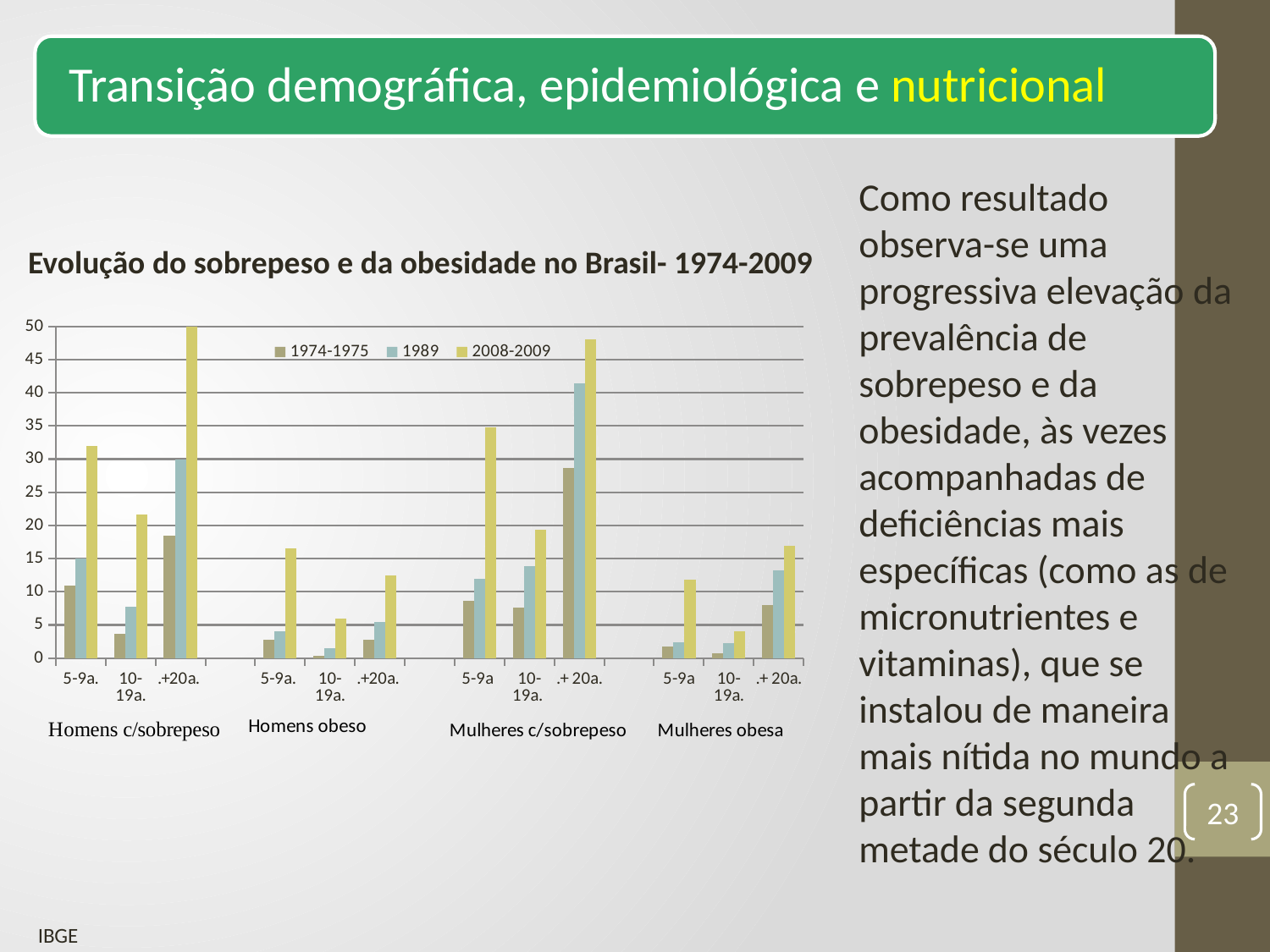
What is the title of the chart? Evolução do sobrepeso e da obesidade no Brasil- 1974-2009 Which group and age band has the tallest bar in the chart? Homens c/sobrepeso, .+20a. (2008-2009) What are the three series named in the legend? 1974-1975, 1989, 2008-2009 Is the 1989 value for Mulheres c/sobrepeso aged .+ 20a. greater or less than 40? greater Within each age band, do the values rise or fall from 1974-1975 to 2008-2009? rise How many series does the legend list? 3 Is the 2008-2009 value for Mulheres c/sobrepeso aged 5-9a greater or less than 30? greater For Mulheres obesa aged .+ 20a., which series has the larger value, 1974-1975 or 2008-2009? 2008-2009 Which series has the lowest value for Homens c/sobrepeso aged 10-19a.? 1974-1975 Is the 2008-2009 value for Homens c/sobrepeso aged .+20a. greater or less than 45? greater What kind of chart is shown on the slide? bar chart